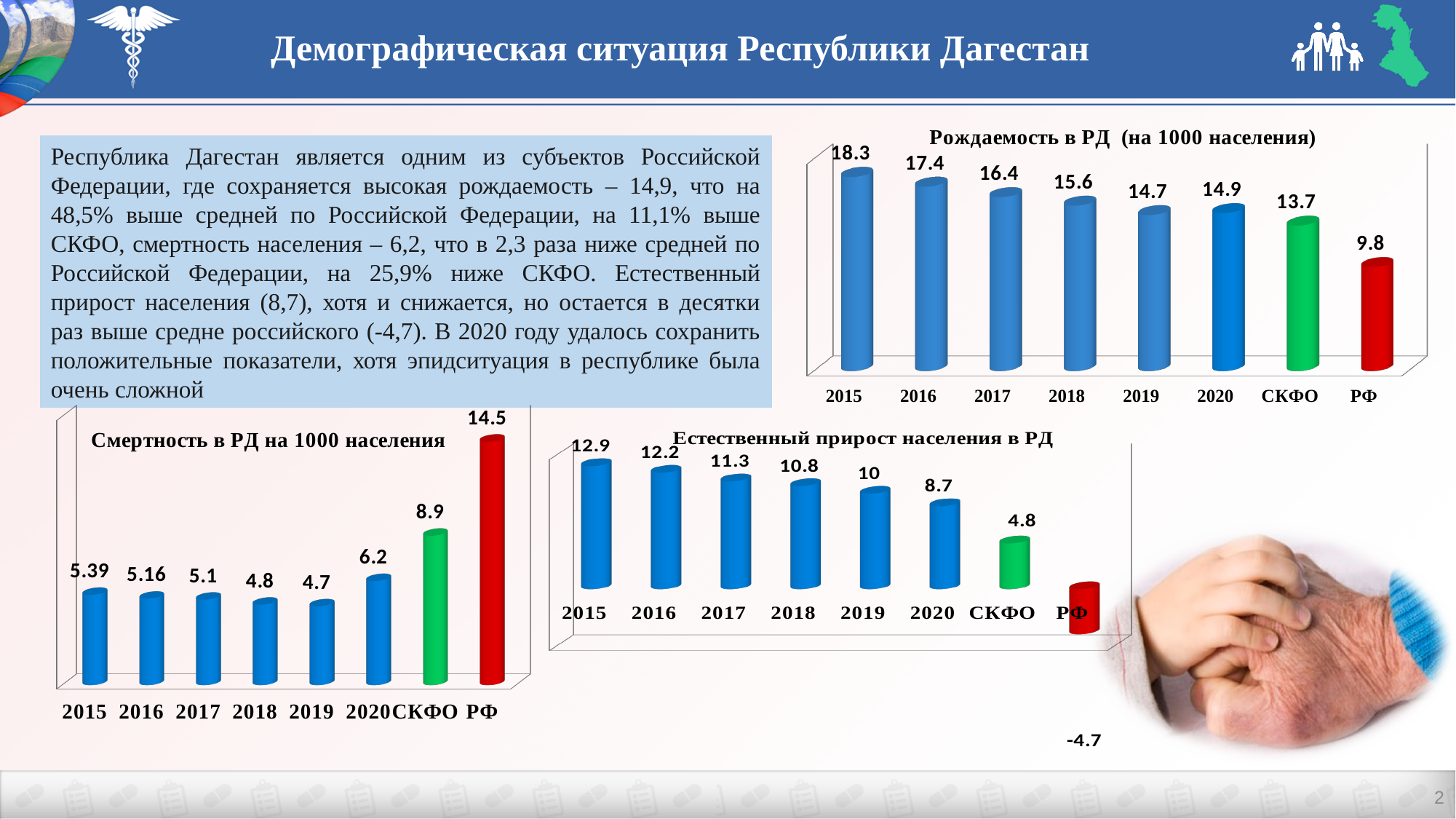
In the chart 'Смертность в РД на 1000 населения', which category has the highest value? РФ In the chart 'Рождаемость в РД (на 1000 населения)', what is the value for 2015? 18.3 In the chart 'Рождаемость в РД (на 1000 населения)', what is the difference between the 2020 value and the СКФО value? 1.2 What type of chart is 'Естественный прирост населения в РД'? bar chart In the chart 'Естественный прирост населения в РД', do the values rise or fall from 2015 to 2020? fall In the chart 'Естественный прирост населения в РД', what is the difference between the 2015 value and the 2020 value? 4.2 In the chart 'Смертность в РД на 1000 населения', what is the difference between the РФ value and the СКФО value? 5.6 In the chart 'Смертность в РД на 1000 населения', what is the value for 2015? 5.39 In the chart 'Рождаемость в РД (на 1000 населения)', how many bars are plotted? 8 In the chart 'Смертность в РД на 1000 населения', which is larger, the value for 2020 or the value for СКФО? СКФО In the chart 'Рождаемость в РД (на 1000 населения)', which category has the lowest value? РФ In the chart 'Естественный прирост населения в РД', what is the value for РФ? -4.7